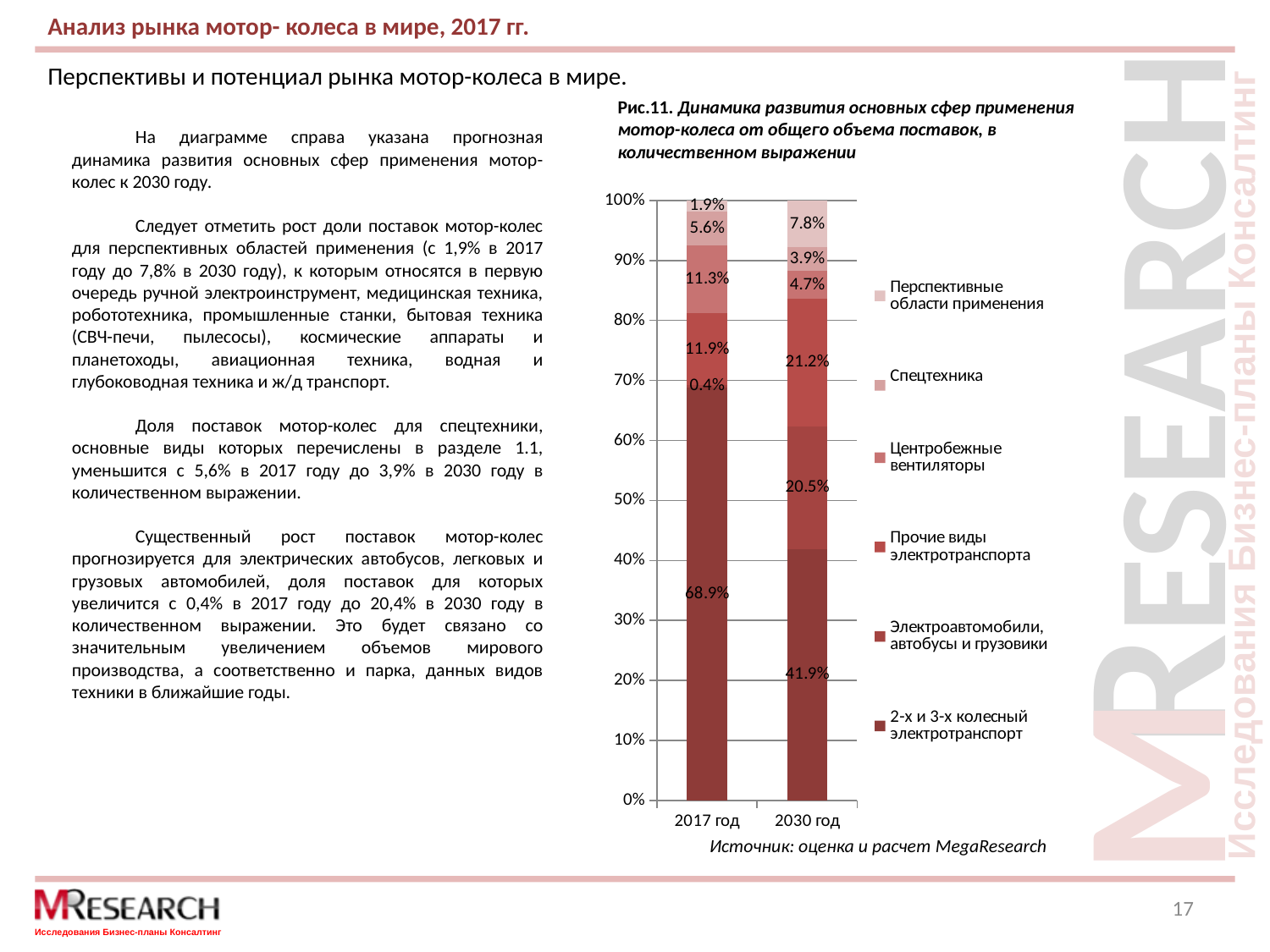
How many categories (years) are shown on the x axis of the chart? 2 How many series does the chart legend list? 6 By how many percentage points does the share of Перспективные области применения change from 2017 год to 2030 год? 5.9 percentage points Which series has the largest share in the 2017 год bar? 2-х и 3-х колесный электротранспорт What type of chart is shown on the slide? Stacked bar chart What is the share of 2-х и 3-х колесный электротранспорт in 2017 год? 68.9% What is the share of Электроавтомобили, автобусы и грузовики in 2030 год? 20.5% Which is larger: the share of Центробежные вентиляторы in 2017 год or in 2030 год? 2017 год What is the share of Перспективные области применения in 2017 год? 1.9% What is the share of Спецтехника in 2030 год? 3.9% Which series has the smallest share in the 2017 год bar? Электроавтомобили, автобусы и грузовики What is the share of 2-х и 3-х колесный электротранспорт in 2030 год? 41.9%